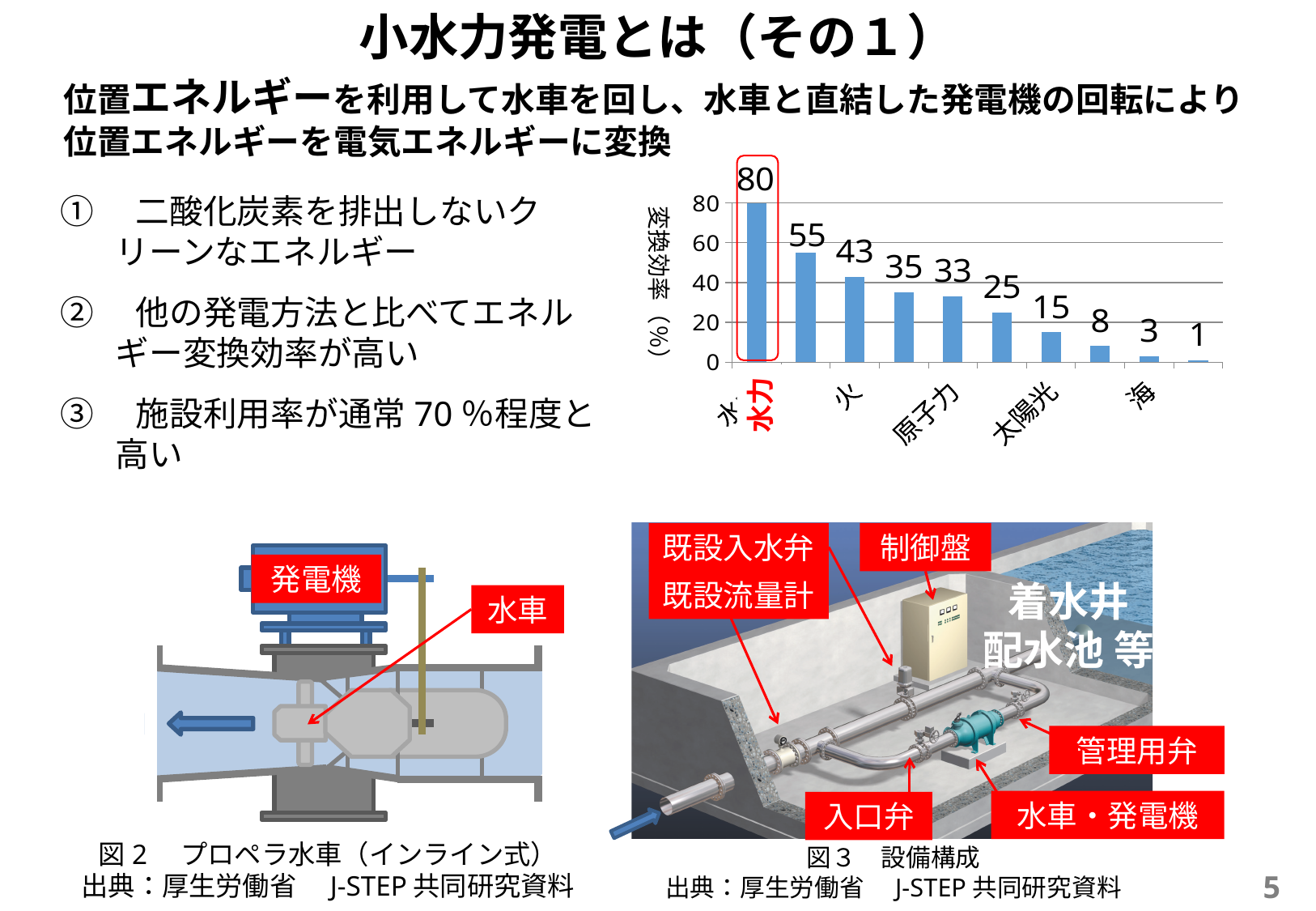
What is the lowest value shown on any bar in the chart? 1 Which is larger, the value for 原子力 or the value for 太陽光? 原子力 What type of chart is shown on the slide? bar chart How many bars are plotted in the chart? 10 Is the value for 水力 greater or less than 60? greater What is the value shown for 太陽光? 15 What is the value shown for 原子力? 33 Which category has the highest conversion efficiency in the chart? 水力 What is the conversion efficiency value shown for 水力? 80 What is the label of the vertical axis of the chart? 変換効率（%） Do the bar values rise or fall from left to right along the x axis? fall What is the difference between the highest bar (80) and the second highest bar (55)? 25